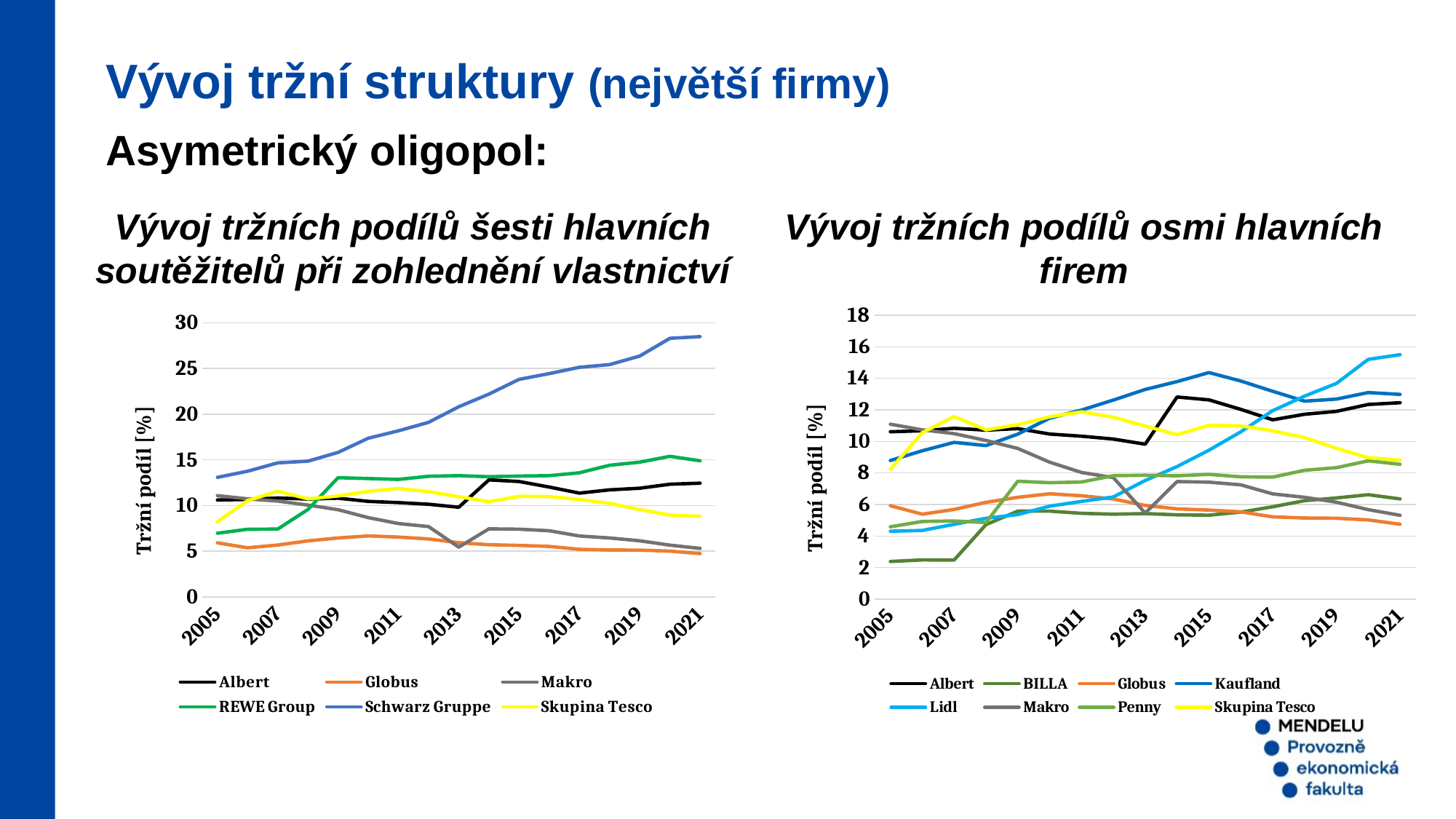
What type of chart is the left chart, 'Vývoj tržních podílů šesti hlavních soutěžitelů při zohlednění vlastnictví'? line chart How many series does the legend of the left chart list? 6 In the right chart, which series has the highest market share in 2021? Lidl In the left chart, is the value for Schwarz Gruppe in 2021 greater or less than 25? greater What is the y-axis label of the right chart? Tržní podíl [%] How many series does the legend of the right chart, 'Vývoj tržních podílů osmi hlavních firem', list? 8 In the left chart, is the value for Globus in 2005 greater or less than 10? less In the right chart, which is larger in 2015, Kaufland or Albert? Kaufland In the right chart, is the value for Lidl in 2021 greater or less than 14? greater In the left chart, does the value for Schwarz Gruppe rise or fall from 2005 to 2021? rise In the right chart, which series has the lowest market share in 2005? BILLA In the left chart, which series has the highest market share in 2021? Schwarz Gruppe